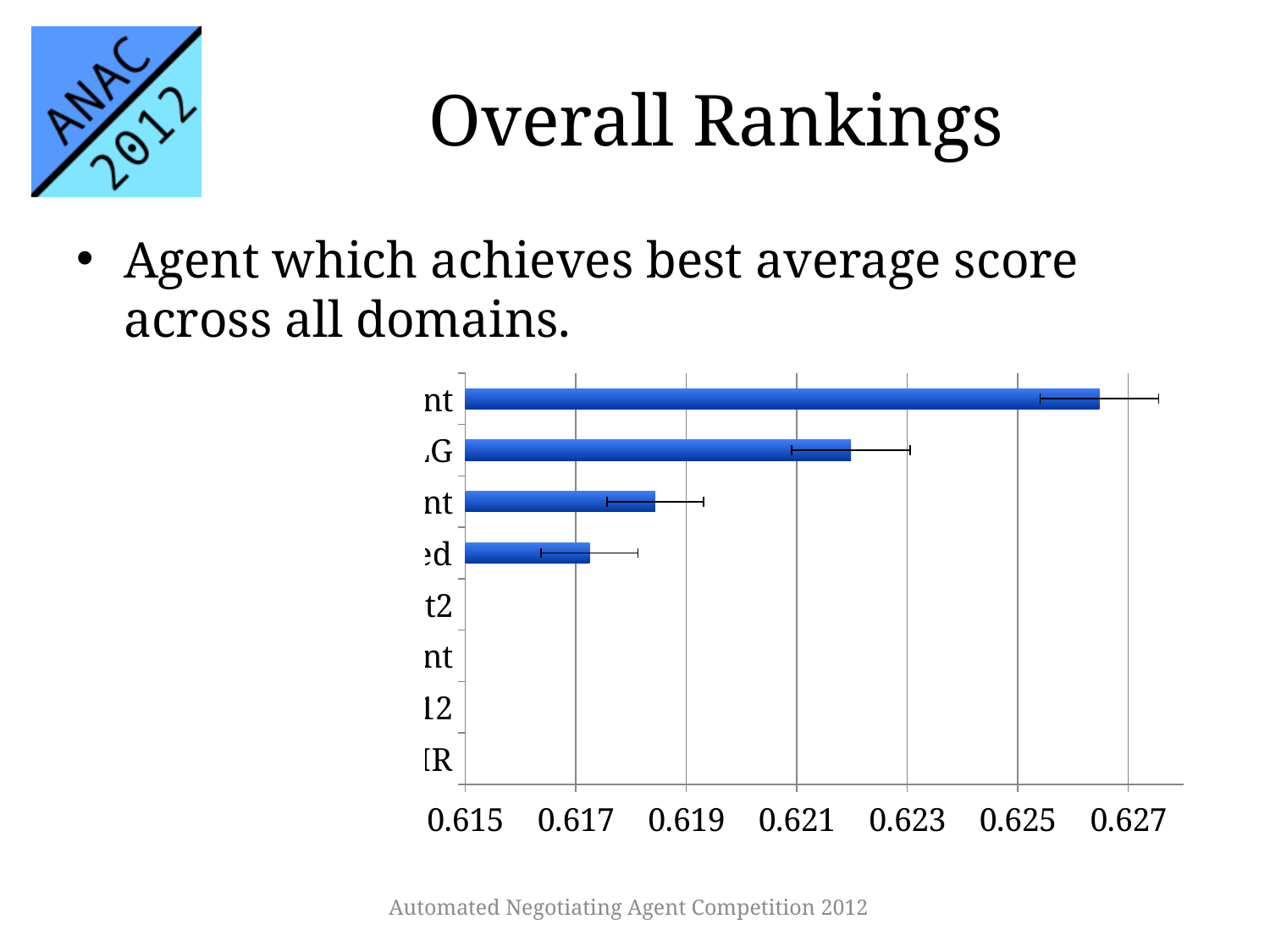
Is the value of the topmost bar in the chart greater or less than 0.625? greater Do the bar lengths in the chart increase or decrease going from the top bar downward? decrease How many bars are visibly plotted in the chart? 4 Is the value of the second bar from the top in the chart greater or less than 0.621? greater What is the highest tick value shown on the horizontal axis of the chart? 0.627 How many category labels are listed on the vertical axis of the chart? 8 What is the lowest value shown on the horizontal axis of the chart? 0.615 Is the value of the fourth bar from the top in the chart greater or less than 0.619? less Which bar in the chart is the longest: the topmost bar or the fourth bar from the top? the topmost bar What kind of chart is shown on the slide? bar chart